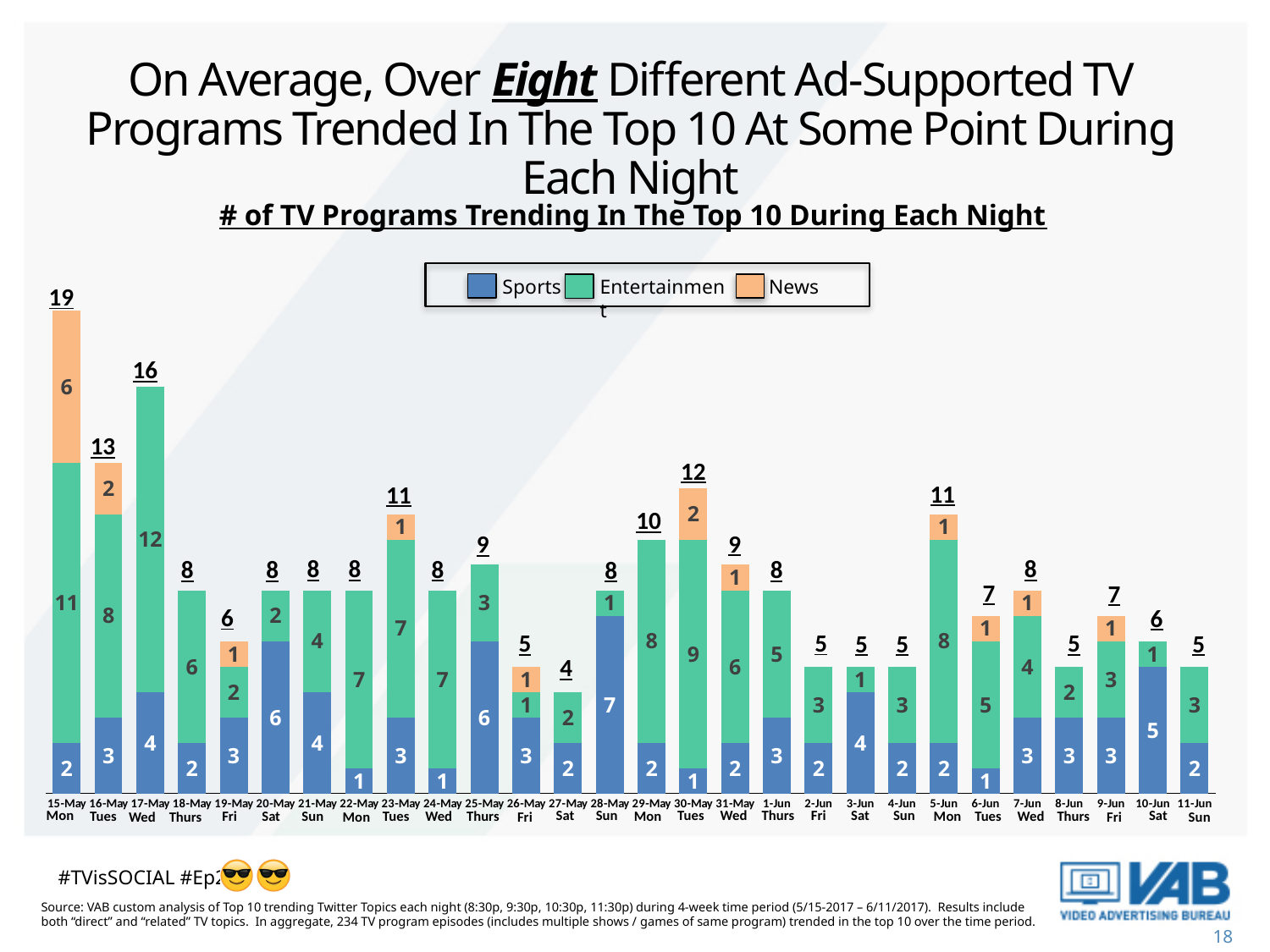
How many News programs trended on 30-May (Tues)? 2 What kind of chart is shown on the slide? Stacked bar chart How many Sports programs trended on 28-May (Sun)? 7 Which is larger: the total for 29-May (Mon) or the total for 5-Jun (Mon)? 5-Jun (Mon) What is the total number of TV programs trending on 15-May (Mon)? 19 How many Entertainment programs trended on 17-May (Wed)? 12 How many nights (bars) are shown on the chart? 28 Which series is shown in orange in the legend? News How many series does the legend list? 3 Which night has the highest total number of trending TV programs? 15-May (Mon) Which night has the lowest total number of trending TV programs? 27-May (Sat) What is the difference between the total for 15-May (Mon) and the total for 16-May (Tues)? 6